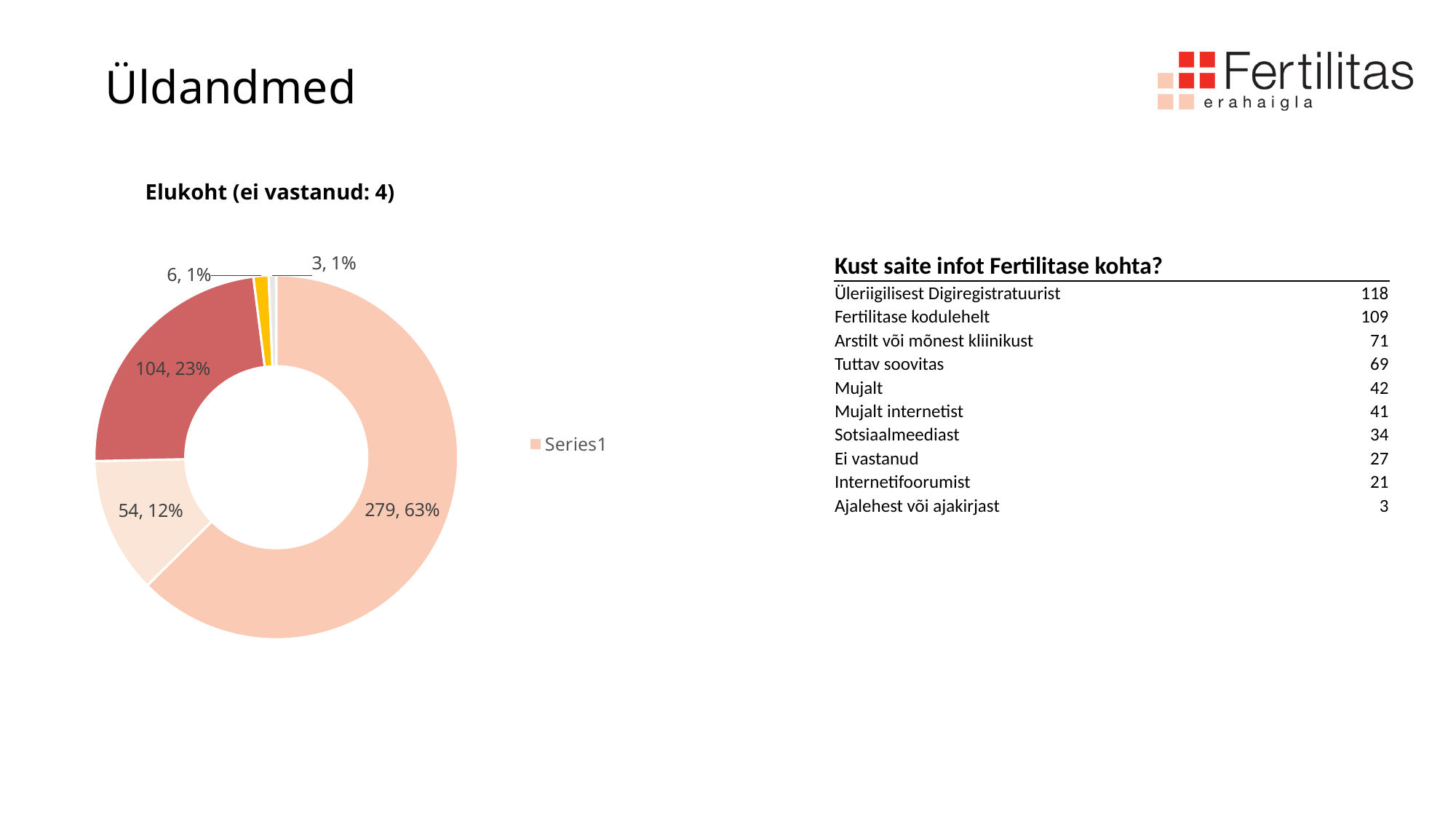
What is the title of the doughnut chart? Elukoht (ei vastanud: 4) How many series does the chart legend list? 1 What share of the doughnut chart does the largest slice represent? 63% What kind of chart is shown on the slide? doughnut chart What is the difference between the largest slice (279) and the dark red slice (104)? 175 What is the value of the dark red slice in the doughnut chart? 104 What is the legend entry shown next to the doughnut chart? Series1 What is the value of the largest slice in the doughnut chart? 279 What is the value of the yellow slice in the doughnut chart? 6 What is the value of the smallest slice in the doughnut chart? 3 What is the total of all slice values in the doughnut chart? 446 How many slices does the doughnut chart have? 5